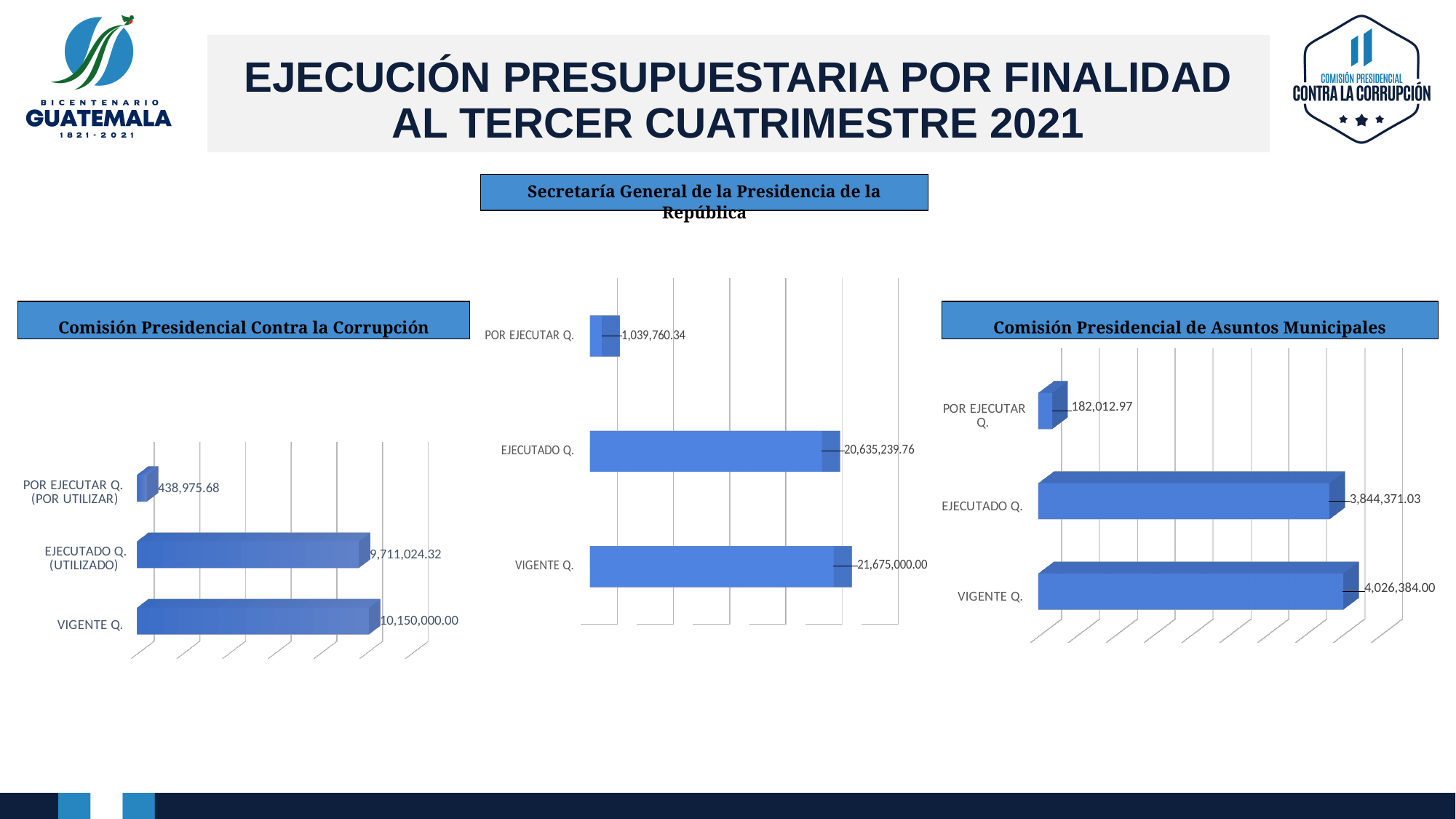
In the Comisión Presidencial de Asuntos Municipales chart, which category has the lowest value? POR EJECUTAR Q. In the Comisión Presidencial de Asuntos Municipales chart, what is the difference between VIGENTE Q. and EJECUTADO Q.? 182,012.97 In the Secretaría General de la Presidencia de la República chart, which category has the highest value? VIGENTE Q. In the Secretaría General de la Presidencia de la República chart, what is the value for EJECUTADO Q.? 20,635,239.76 In the Secretaría General de la Presidencia de la República chart, which is larger, EJECUTADO Q. or POR EJECUTAR Q.? EJECUTADO Q. In the Comisión Presidencial Contra la Corrupción chart, what is the difference between VIGENTE Q. and EJECUTADO Q. (UTILIZADO)? 438,975.68 How many categories does the Comisión Presidencial de Asuntos Municipales chart show? 3 In the Comisión Presidencial Contra la Corrupción chart, what is the value for EJECUTADO Q. (UTILIZADO)? 9,711,024.32 In the Secretaría General de la Presidencia de la República chart, what is the value for POR EJECUTAR Q.? 1,039,760.34 In the Comisión Presidencial Contra la Corrupción chart, what is the value for VIGENTE Q.? 10,150,000.00 What kind of chart is the Comisión Presidencial Contra la Corrupción chart? Bar chart In the Comisión Presidencial de Asuntos Municipales chart, what is the value for VIGENTE Q.? 4,026,384.00